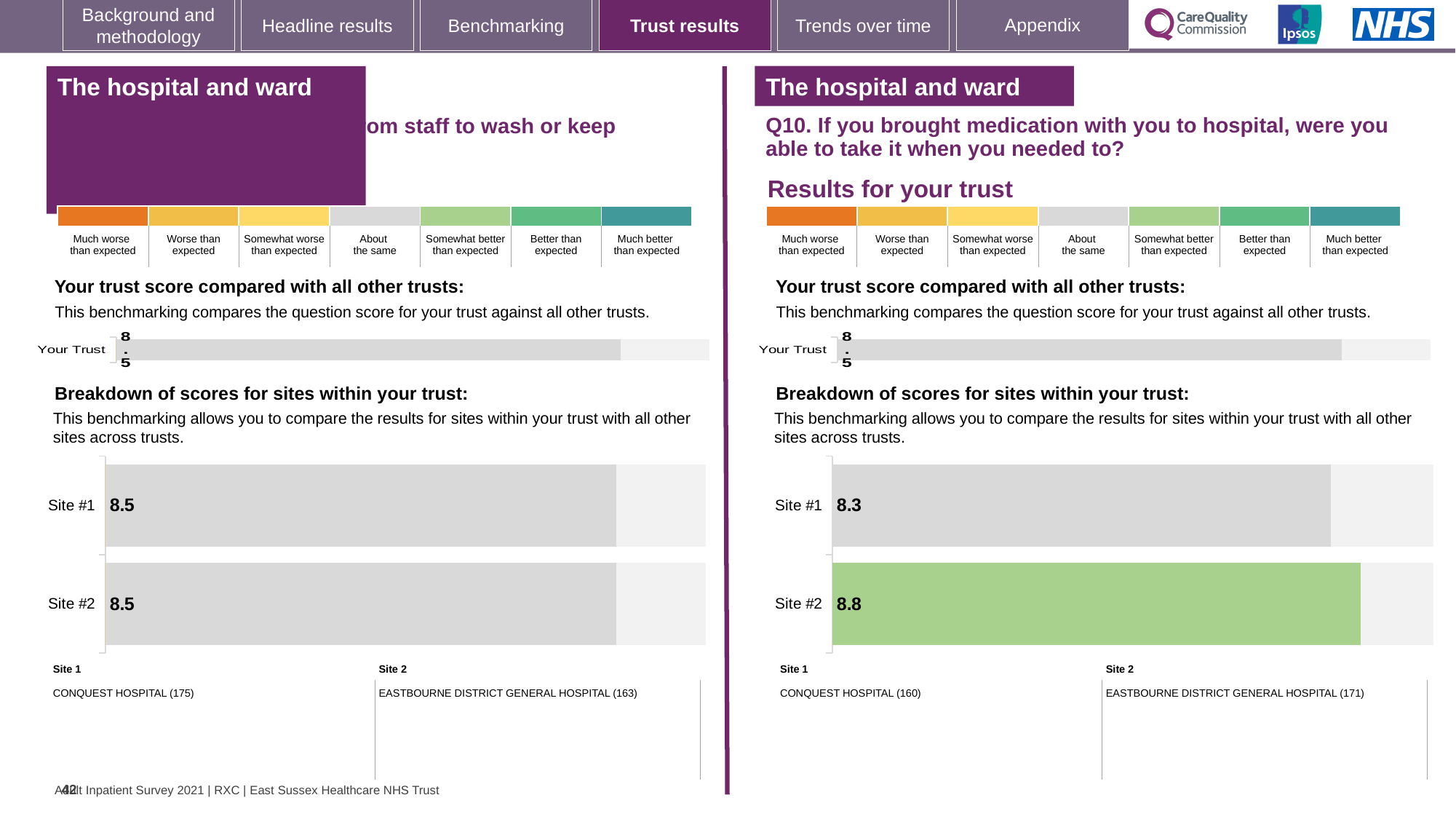
On the right-hand (Q10) chart, is the score for Site #1 larger or smaller than the score for Site #2? smaller How many sites are shown in the site breakdown chart on the right-hand (Q10) side? 2 On the right-hand (Q10) chart, what is the 'Your Trust' score compared with all other trusts? 8.5 On the right-hand (Q10) chart, what is the score for Site #1? 8.3 On the right-hand (Q10) chart, which hospital is Site 2? EASTBOURNE DISTRICT GENERAL HOSPITAL (171) What type of chart is used for the breakdown of scores for sites on the right-hand (Q10) side? bar chart On the left-hand chart, what is the score for Site #2? 8.5 On the left-hand chart, what is the score for Site #1? 8.5 On the left-hand chart, what is the 'Your Trust' score compared with all other trusts? 8.5 On the right-hand (Q10) chart, which site has the higher score? Site #2 On the right-hand (Q10) chart, what is the difference between the Site #2 and Site #1 scores? 0.5 On the right-hand (Q10) chart, what is the score for Site #2? 8.8